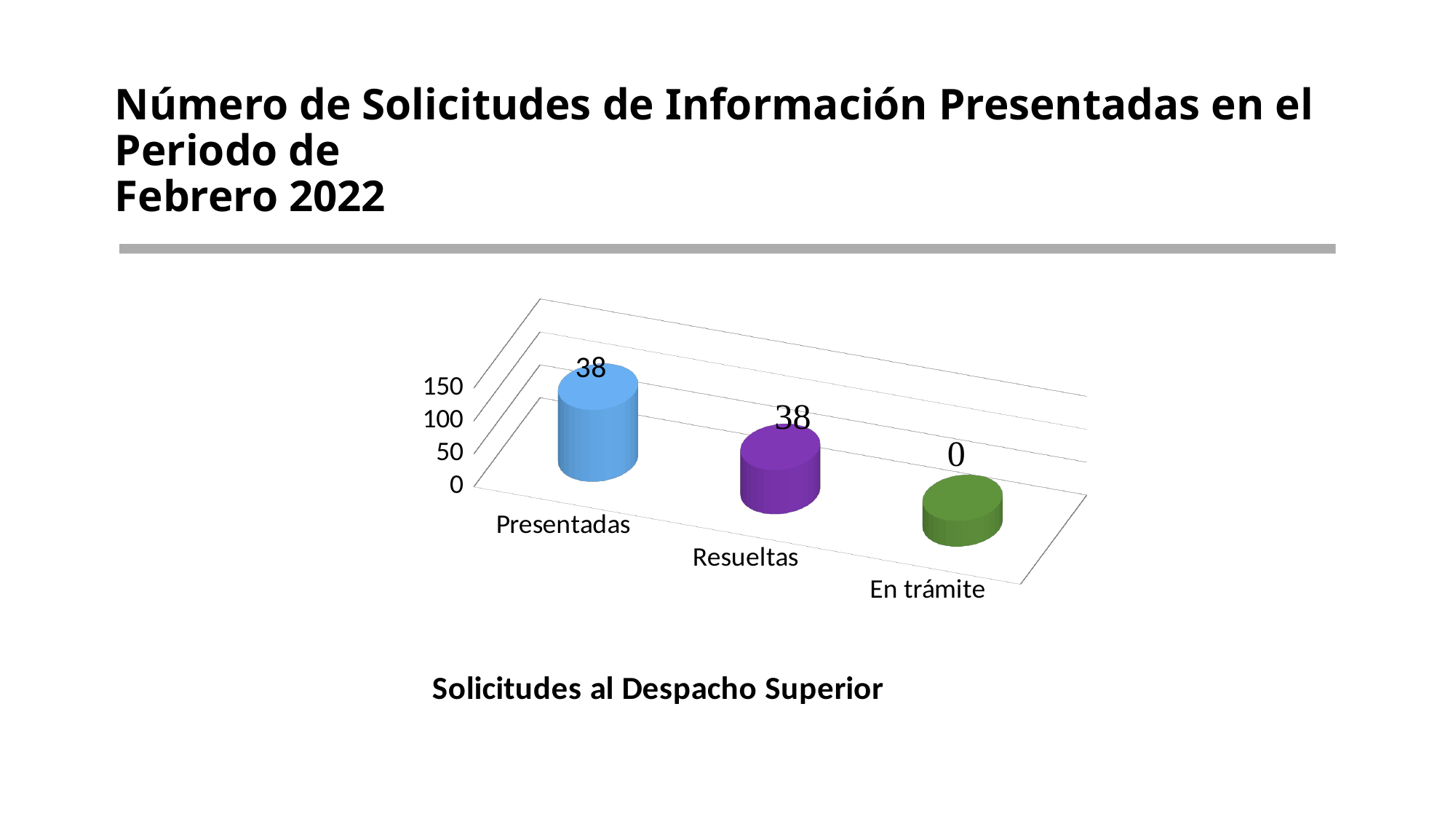
Which category has the lowest value? En trámite Which is larger, the value for Presentadas or the value for En trámite? Presentadas What is the title shown below the chart? Solicitudes al Despacho Superior How many categories are shown in the chart? 3 Is the value for Presentadas greater or less than 50? greater What colour is the bar for Resueltas? purple What kind of chart is shown on the slide? bar chart